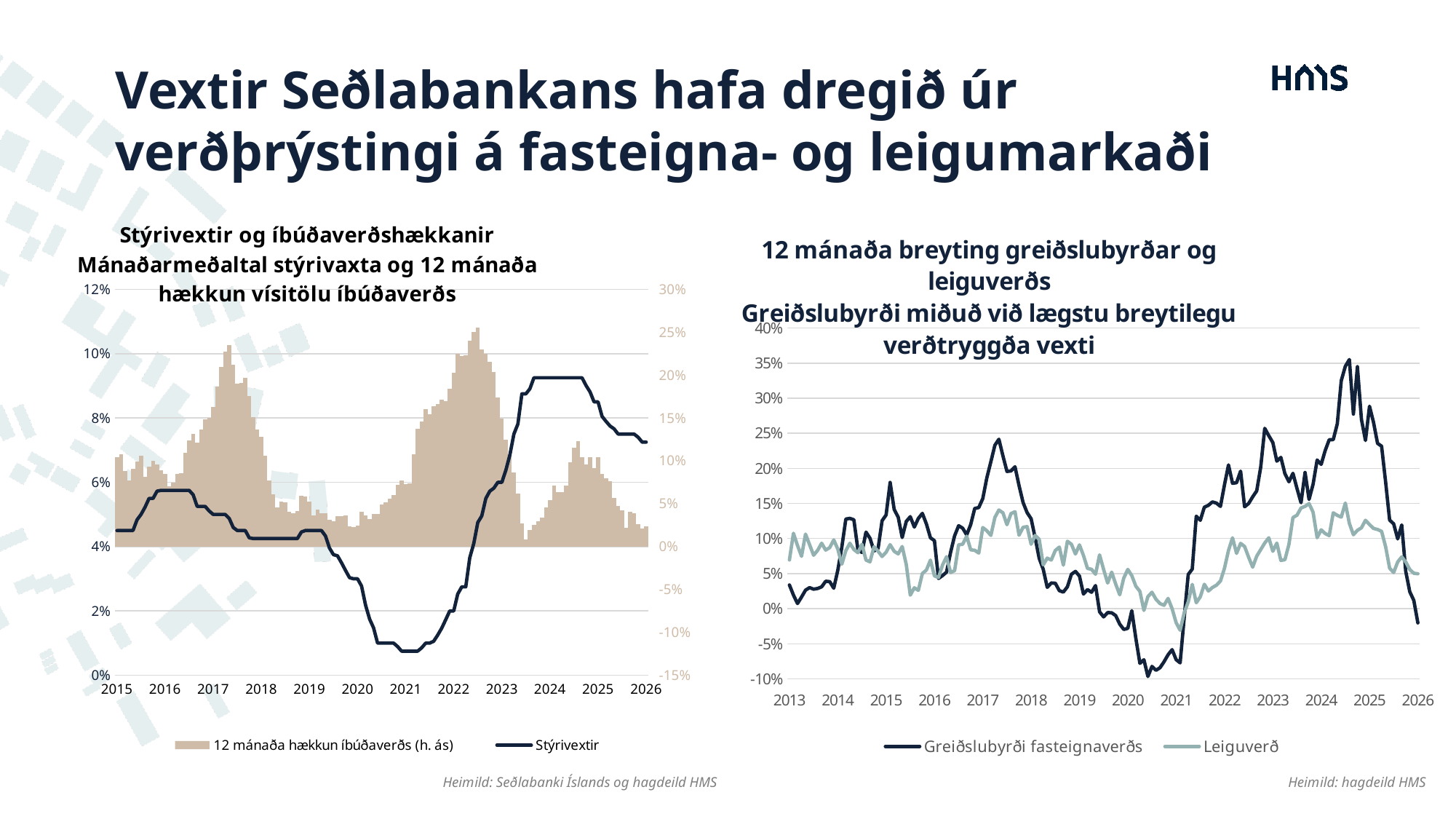
In the right chart, which series is drawn in the lighter grey-green colour? Leiguverð In the left chart, which series is plotted as bars? 12 mánaða hækkun íbúðaverðs (h. ás) What kind of chart is the left chart, "Stýrivextir og íbúðaverðshækkanir"? A combined bar and line chart How many series does the legend of the right chart list? 2 In the right chart, is the highest value of Leiguverð greater or less than 20%? less In the right chart, is the peak of Greiðslubyrði fasteignaverðs in 2024 greater or less than 30%? greater How many series does the legend of the left chart list? 2 In the right chart, does Greiðslubyrði fasteignaverðs rise or fall between 2025 and 2026? Fall In the left chart, is the Stýrivextir value during 2021 greater or less than 2%? less In the right chart, which series is higher at its 2024 peak, Greiðslubyrði fasteignaverðs or Leiguverð? Greiðslubyrði fasteignaverðs What kind of chart is the right chart, "12 mánaða breyting greiðslubyrðar og leiguverðs"? Line chart